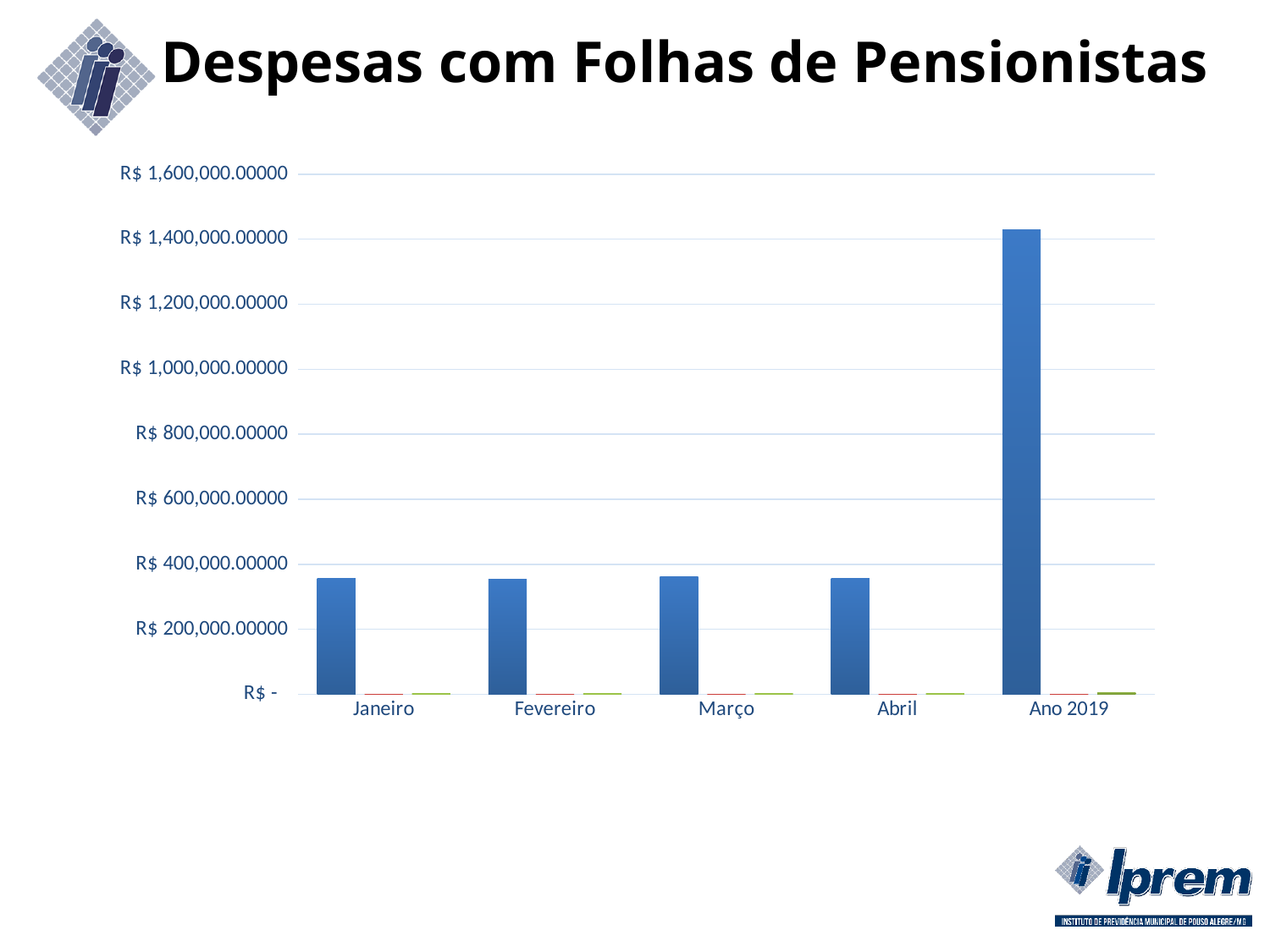
Which category has the highest blue bar in the chart? Ano 2019 Which is larger, the blue bar for Ano 2019 or the blue bar for Abril? Ano 2019 Is the blue bar value for Ano 2019 greater or less than R$ 1,600,000.00000? less What is the title of the chart? Despesas com Folhas de Pensionistas Is the blue bar value for Janeiro greater or less than R$ 200,000.00000? greater Is the blue bar value for Março greater or less than R$ 400,000.00000? less What kind of chart is shown on the slide? bar chart What is the label of the last category on the x axis? Ano 2019 How many categories are shown on the x axis of the chart? 5